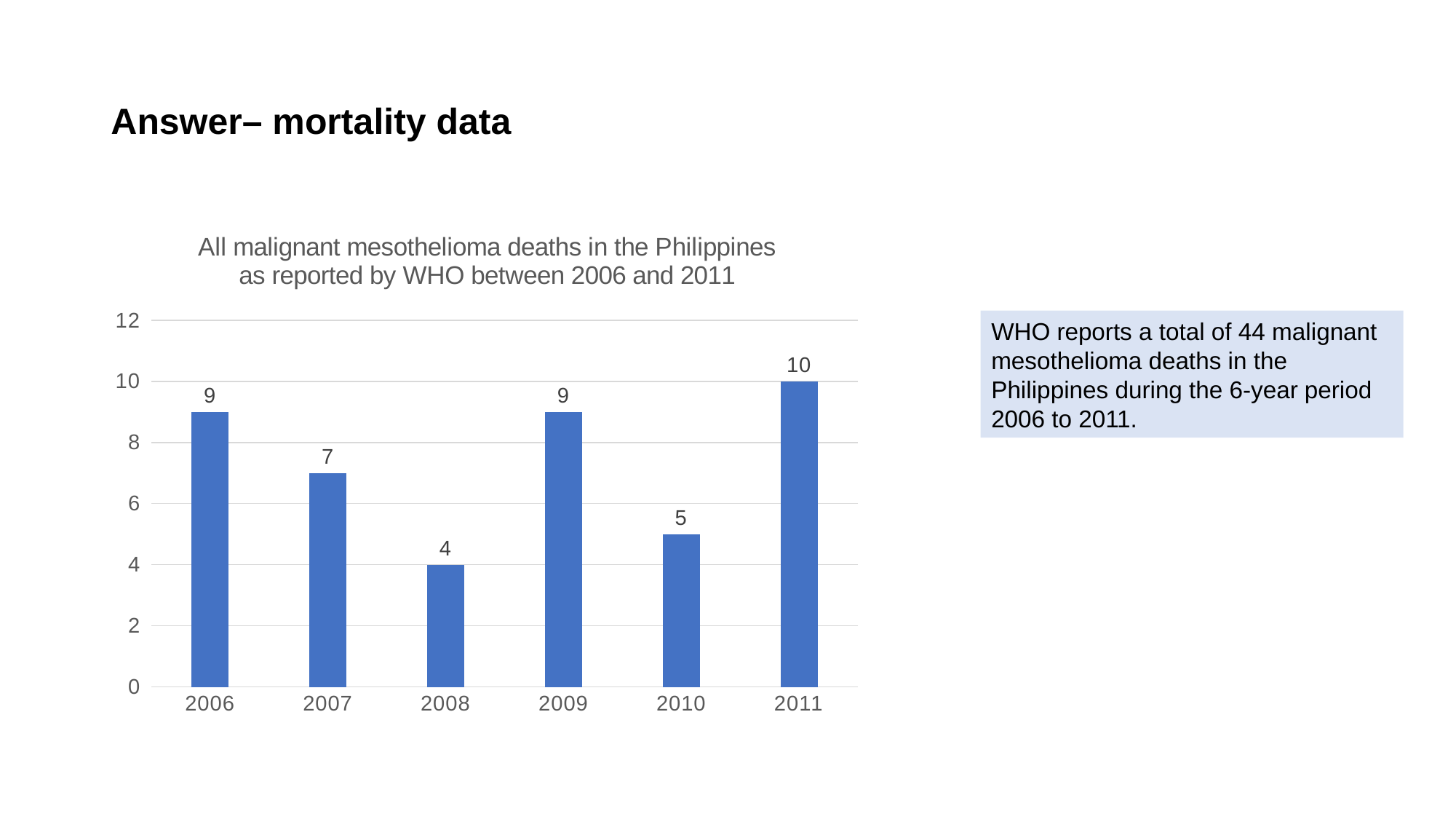
Which is larger, the value for 2007 or the value for 2010? 2007 What is the value for 2011? 10 Which year has the highest value? 2011 Is the value for 2009 greater or less than 8? greater Which year has the lowest value? 2008 What is the difference between the values for 2011 and 2008? 6 What kind of chart is shown on the slide? bar chart How many years are shown on the x axis? 6 What is the value for 2006? 9 What is the title of the chart? All malignant mesothelioma deaths in the Philippines as reported by WHO between 2006 and 2011 What is the value for 2008? 4 What is the difference between the values for 2007 and 2010? 2